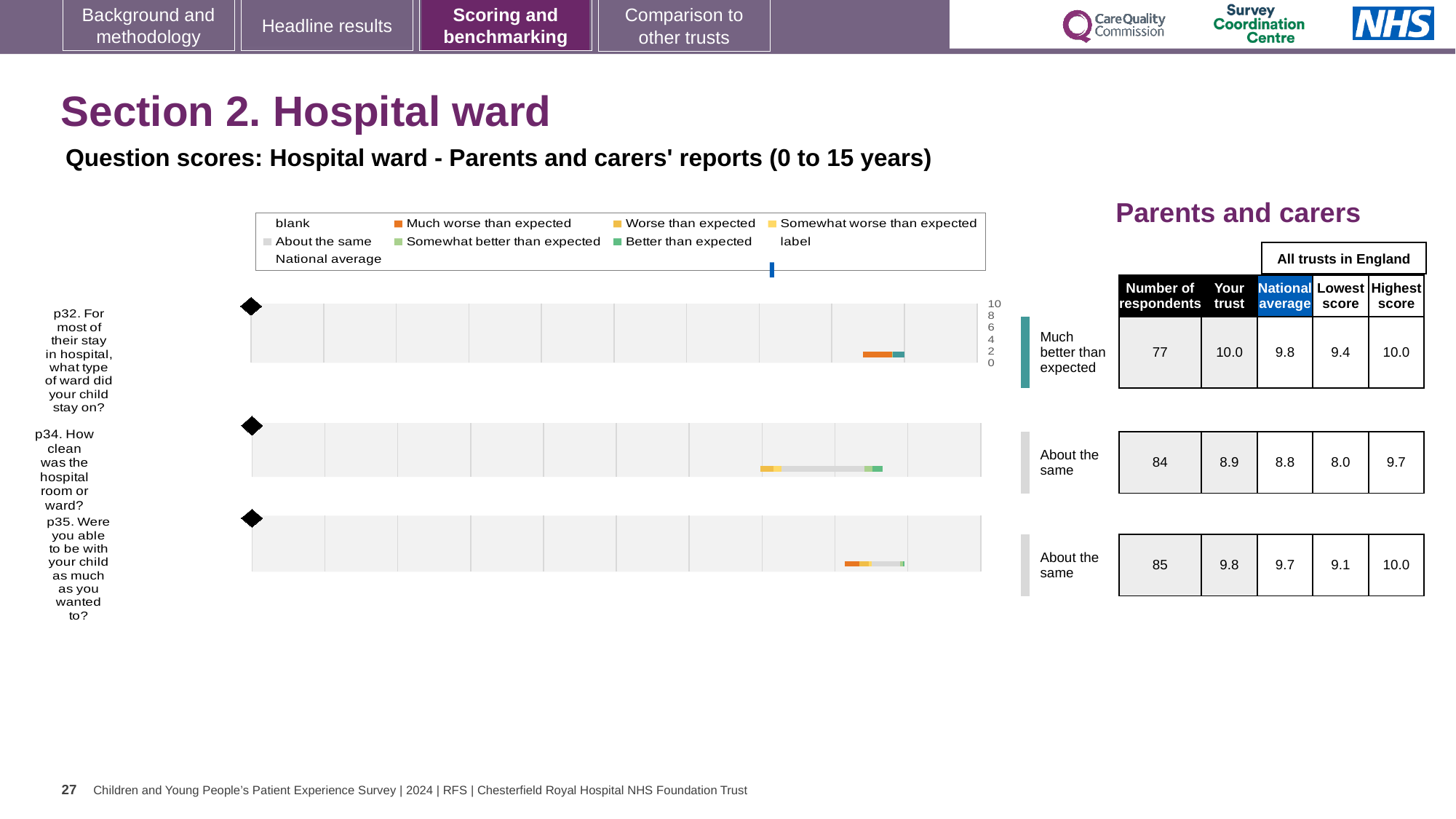
What kind of chart is used to show the question scores for the hospital ward? Bar chart What is the highest score across all trusts in England for p34? 9.7 What is the 'Your trust' score for p32 (what type of ward did your child stay on)? 10.0 Which question has the highest 'Your trust' score? p32 Which benchmark category is shown for p32? Much better than expected What is the national average score for p34 (how clean was the hospital room or ward)? 8.8 What does the orange legend entry represent? Much worse than expected Which question has the lowest 'Your trust' score? p34 For p35, which is larger: the 'Your trust' score or the national average? Your trust How many respondents answered p35 (were you able to be with your child as much as you wanted to)? 85 What is the difference between the 'Your trust' scores for p32 and p34? 1.1 How many questions (categories) are plotted in the chart? 3